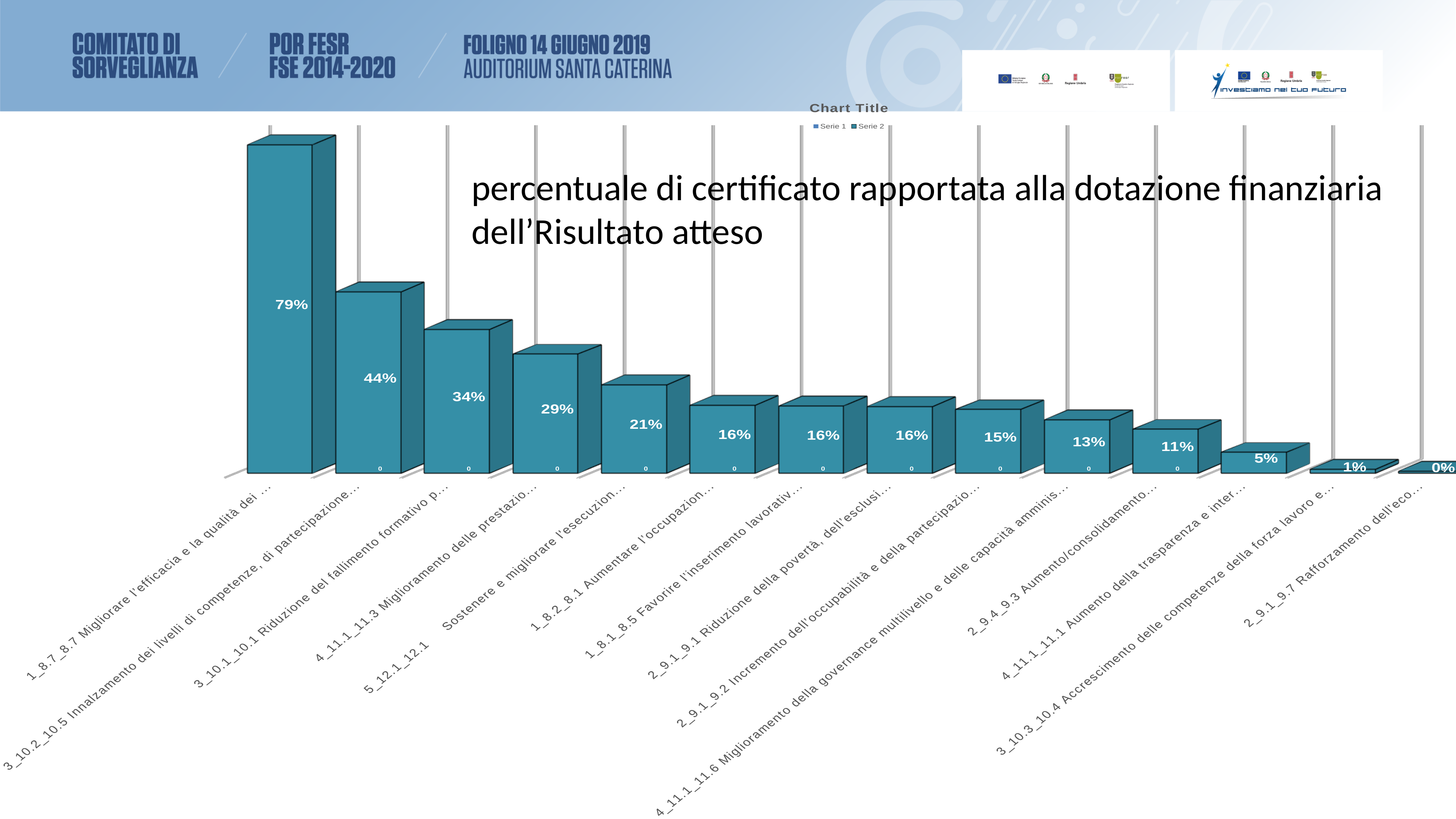
Which category has the highest value in the chart? 1_8.7_8.7 Migliorare l'efficacia e la qualità dei... What kind of chart is shown on the slide? Bar chart Which category has the lowest value in the chart? 2_9.1_9.7 Rafforzamento dell'eco... What is the value shown for the category labelled 1_8.7_8.7 Migliorare l'efficacia e la qualità dei...? 79% What is the value shown for the category labelled 5_12.1_12.1 Sostenere e migliorare l'esecuzion...? 21% Which has the larger value: 3_10.1_10.1 Riduzione del fallimento formativo or 4_11.1_11.3 Miglioramento delle prestazio...? 3_10.1_10.1 Riduzione del fallimento formativo What is the difference between the values for 1_8.7_8.7 and 3_10.2_10.5? 35 percentage points What is the value shown for the category labelled 3_10.3_10.4 Accrescimento delle competenze della forza lavoro e...? 1% What is the value shown for the category labelled 3_10.2_10.5 Innalzamento dei livelli di competenze...? 44% Do the values rise or fall moving from left to right along the x axis? Fall How many categories (bars) are plotted in the chart? 14 How many series does the chart legend list? 2